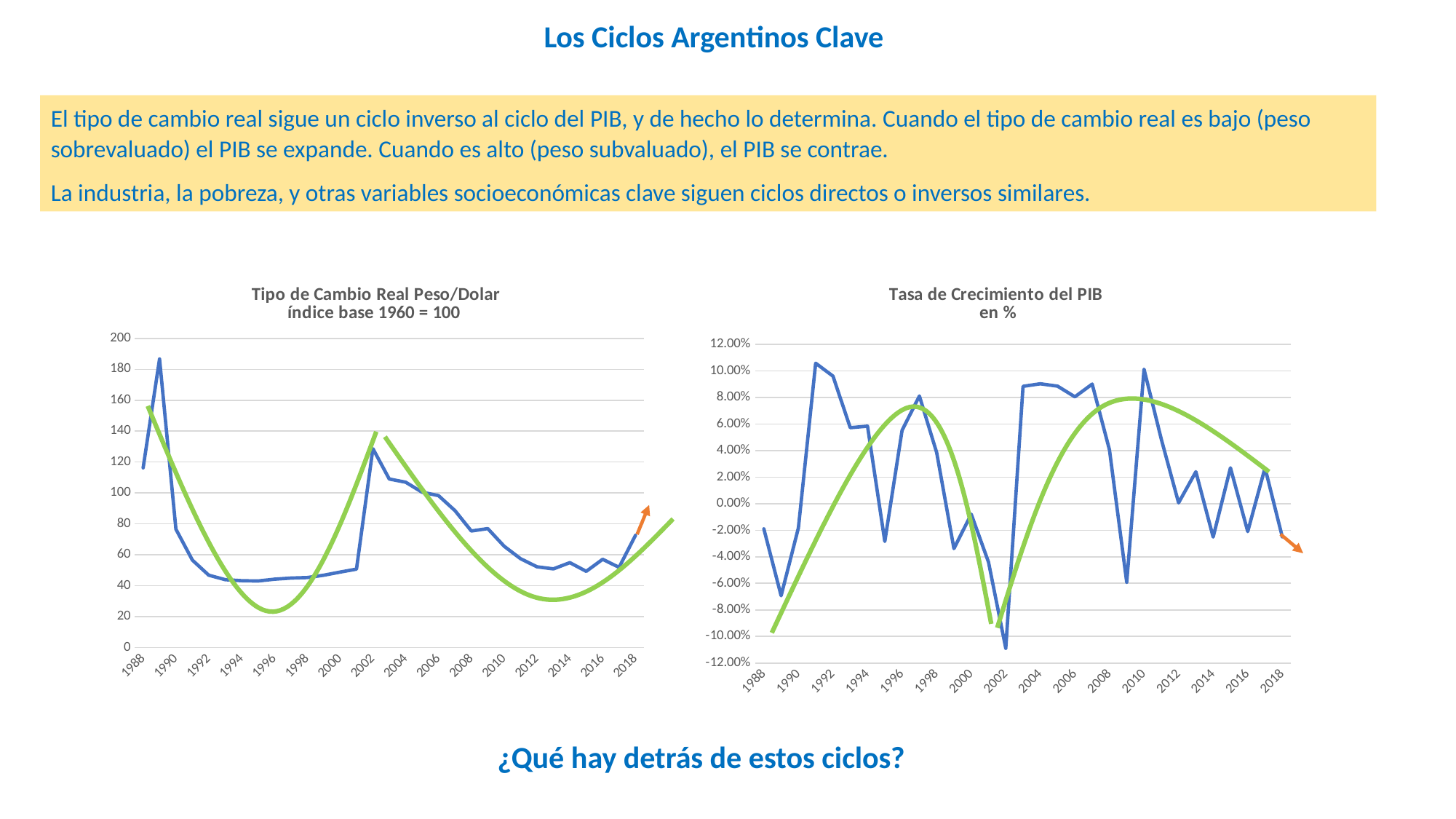
In the 'Tipo de Cambio Real Peso/Dolar' chart, is the value for 1996 greater or less than 60? less What is the base year of the index in the title of the left chart? 1960 = 100 What kind of chart is the 'Tipo de Cambio Real Peso/Dolar' chart on the left? line chart In the 'Tasa de Crecimiento del PIB' chart, is the value for 2002 greater or less than -10.00%? less In the 'Tasa de Crecimiento del PIB' chart, in which year does the blue line reach its lowest value? 2002 In the 'Tipo de Cambio Real Peso/Dolar' chart, is the value for 1989 greater or less than 160? greater In the 'Tipo de Cambio Real Peso/Dolar' chart, does the blue line generally rise or fall between 2002 and 2012? fall In the 'Tipo de Cambio Real Peso/Dolar' chart, which year has the higher value, 1989 or 2002? 1989 In the 'Tasa de Crecimiento del PIB' chart, which year has the higher value, 1991 or 2002? 1991 What kind of chart is the 'Tasa de Crecimiento del PIB' chart on the right? line chart In the 'Tipo de Cambio Real Peso/Dolar' chart, in which year does the blue line reach its highest value? 1989